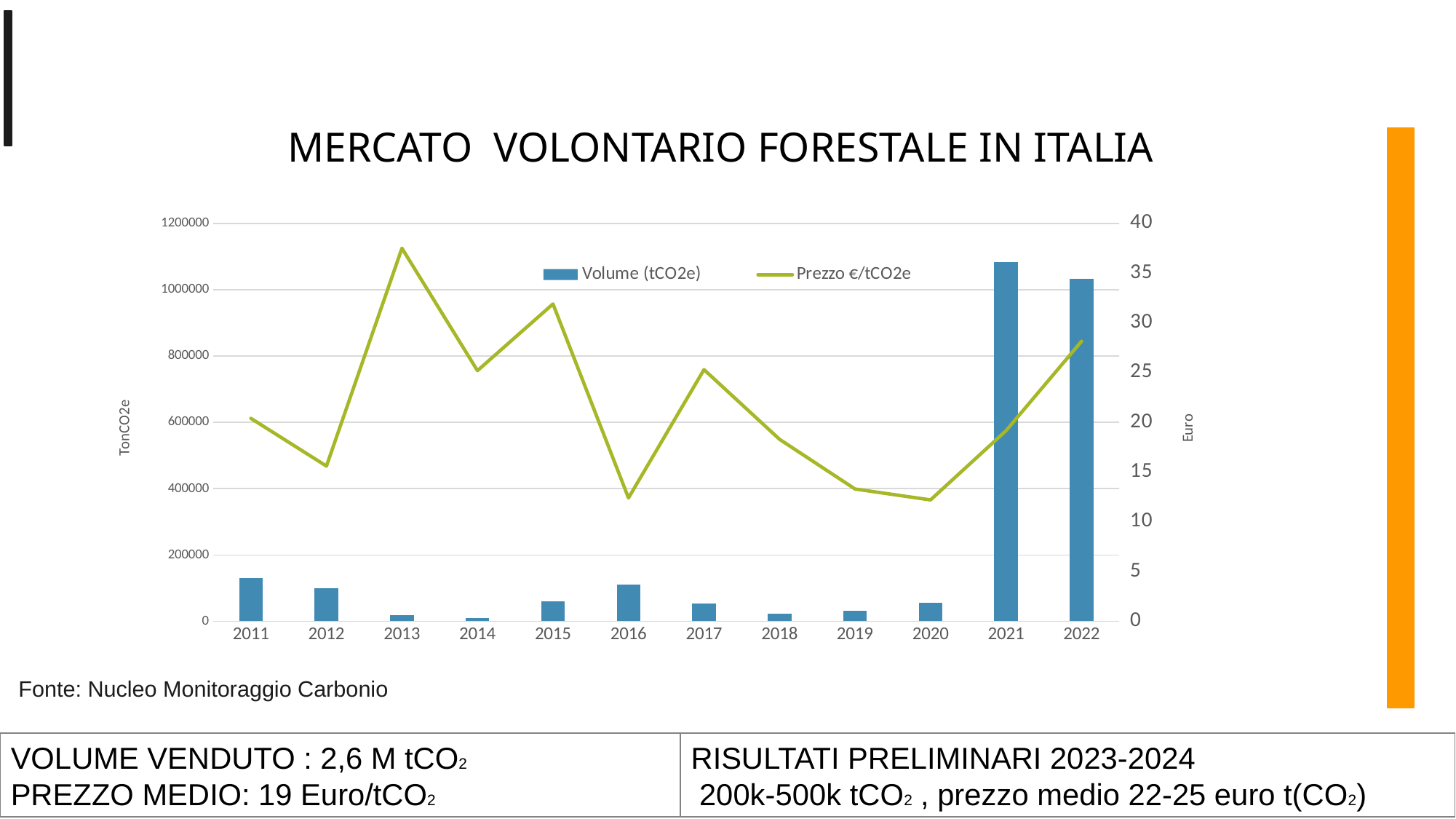
Is the Volume (tCO2e) value for 2021 greater or less than 1000000? greater Is the Prezzo €/tCO2e value for 2013 greater or less than 35? greater In which year does the Prezzo €/tCO2e line reach its highest point? 2013 Is the Prezzo €/tCO2e value for 2016 greater or less than 15? less What kind of chart is shown on the slide? A combination bar and line chart Which year has the highest Volume (tCO2e) bar? 2021 Which year has the larger Volume (tCO2e) bar, 2011 or 2012? 2011 How many series does the chart legend list? 2 How many years are shown on the x axis of the chart? 12 Which year has the lowest Volume (tCO2e) bar? 2014 Does the Prezzo €/tCO2e line rise or fall from 2017 to 2020? It falls